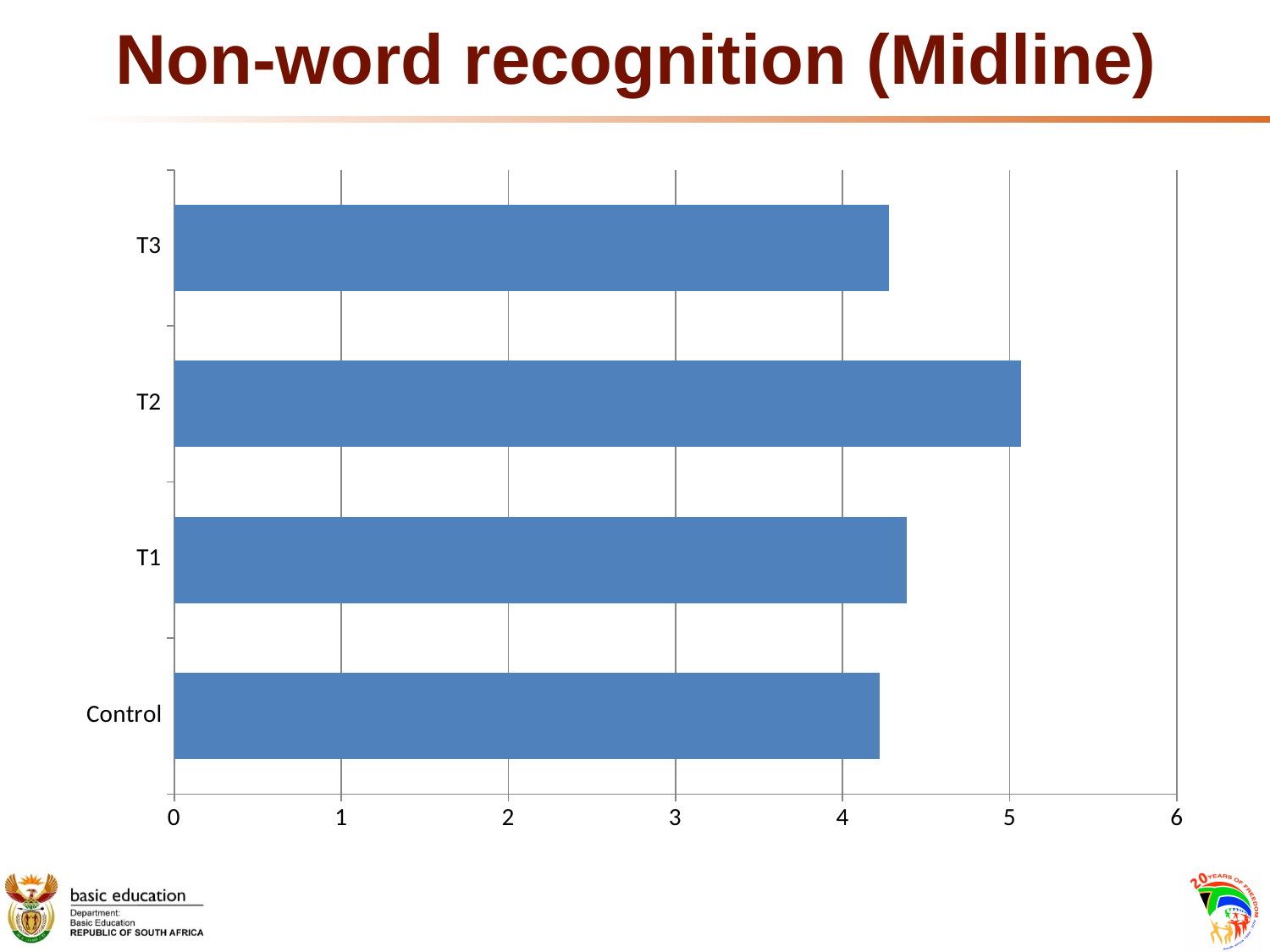
Which is larger, the value for T3 or the value for T2? T2 Is the value for Control greater or less than 3? greater What is the title of the slide containing the chart? Non-word recognition (Midline) How many categories are plotted in the chart? 4 Which category has the highest value in the chart? T2 Is the value for T1 greater or less than 5? less Is the value for T2 greater or less than 4? greater Which is larger, the value for T2 or the value for Control? T2 What is the maximum value shown on the horizontal axis of the chart? 6 What kind of chart is shown on the slide? bar chart